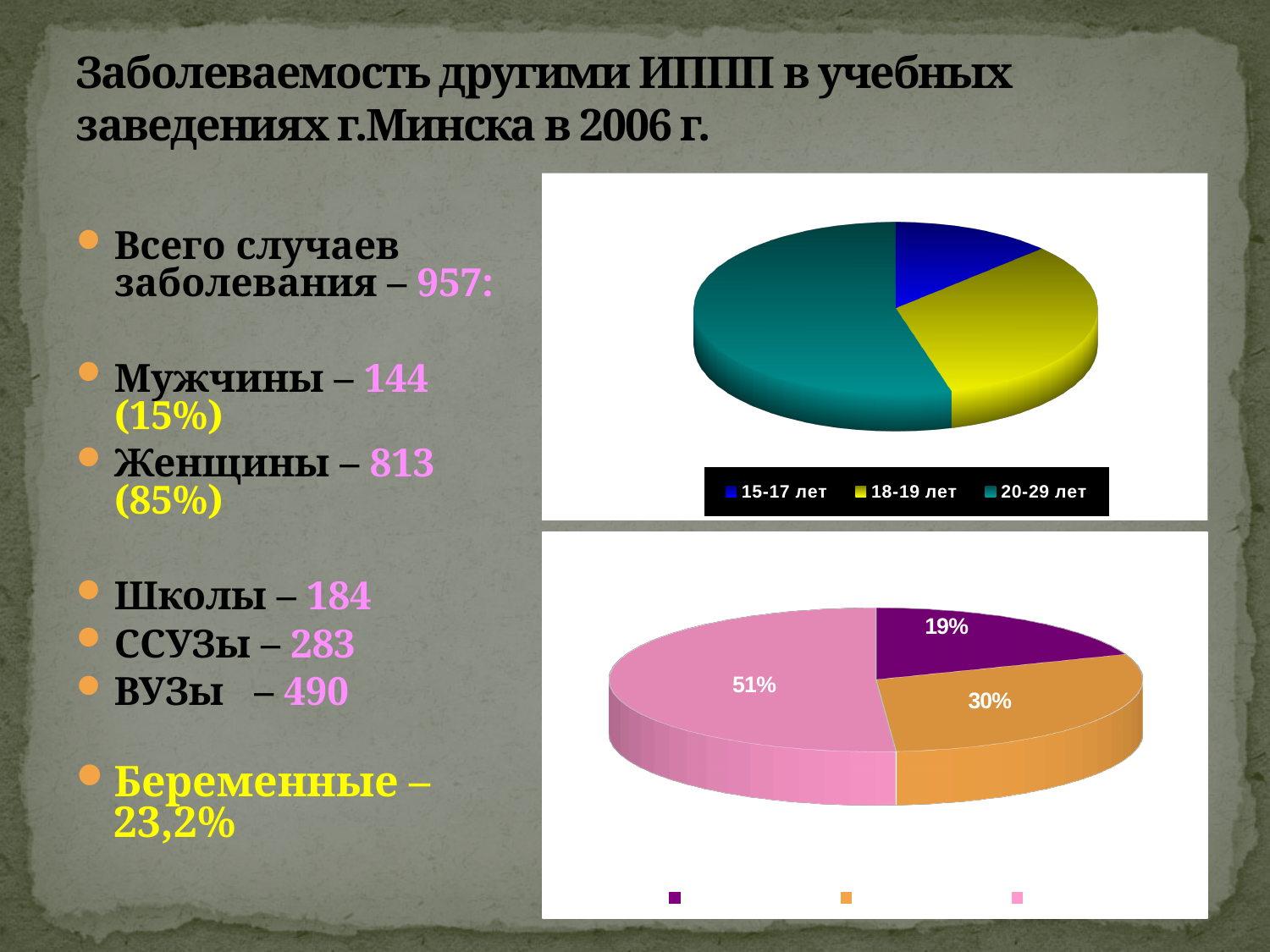
In the bottom chart, what is the value of the largest slice? 51% In the top chart, which slice is larger: 18-19 лет or 15-17 лет? 18-19 лет In the bottom chart, what is the difference between the largest and the smallest slice? 32% What kind of chart is the bottom chart on the slide? pie chart In the bottom chart, what percentage is shown on the orange slice? 30% In the bottom chart, what percentage is shown on the purple slice? 19% How many entries does the legend of the top chart list? 3 How many slices does the bottom pie chart have? 3 What kind of chart is the top chart on the slide? pie chart In the bottom chart, what percentage is shown on the pink slice? 51% In the top chart, which age group has the smallest slice? 15-17 лет In the top chart, which age group has the largest slice? 20-29 лет